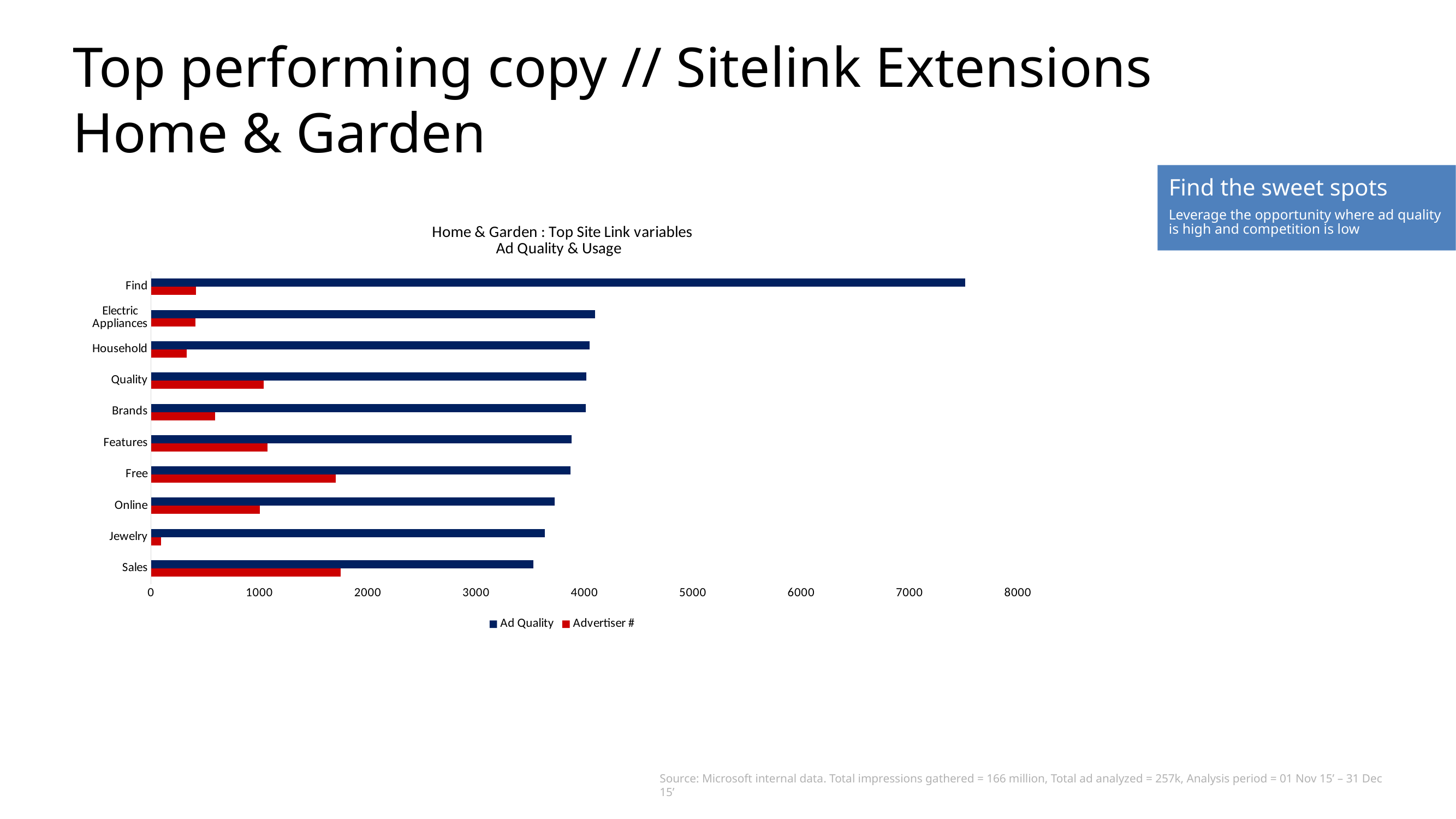
Which is larger, the Ad Quality value for Find or for Household? Find What kind of chart is shown on the slide? Bar chart Which is larger, the Advertiser # value for Quality or for Brands? Quality How many series does the legend list? 2 Is the Advertiser # value for Free greater or less than 1000? greater How many categories are plotted on the chart? 10 Is the Ad Quality value for Sales greater or less than 3000? greater Is the Ad Quality value for Find greater or less than 7000? greater What colour represents the Advertiser # series in the chart? Red Which category has the lowest Advertiser # value? Jewelry Which category has the highest Ad Quality value? Find